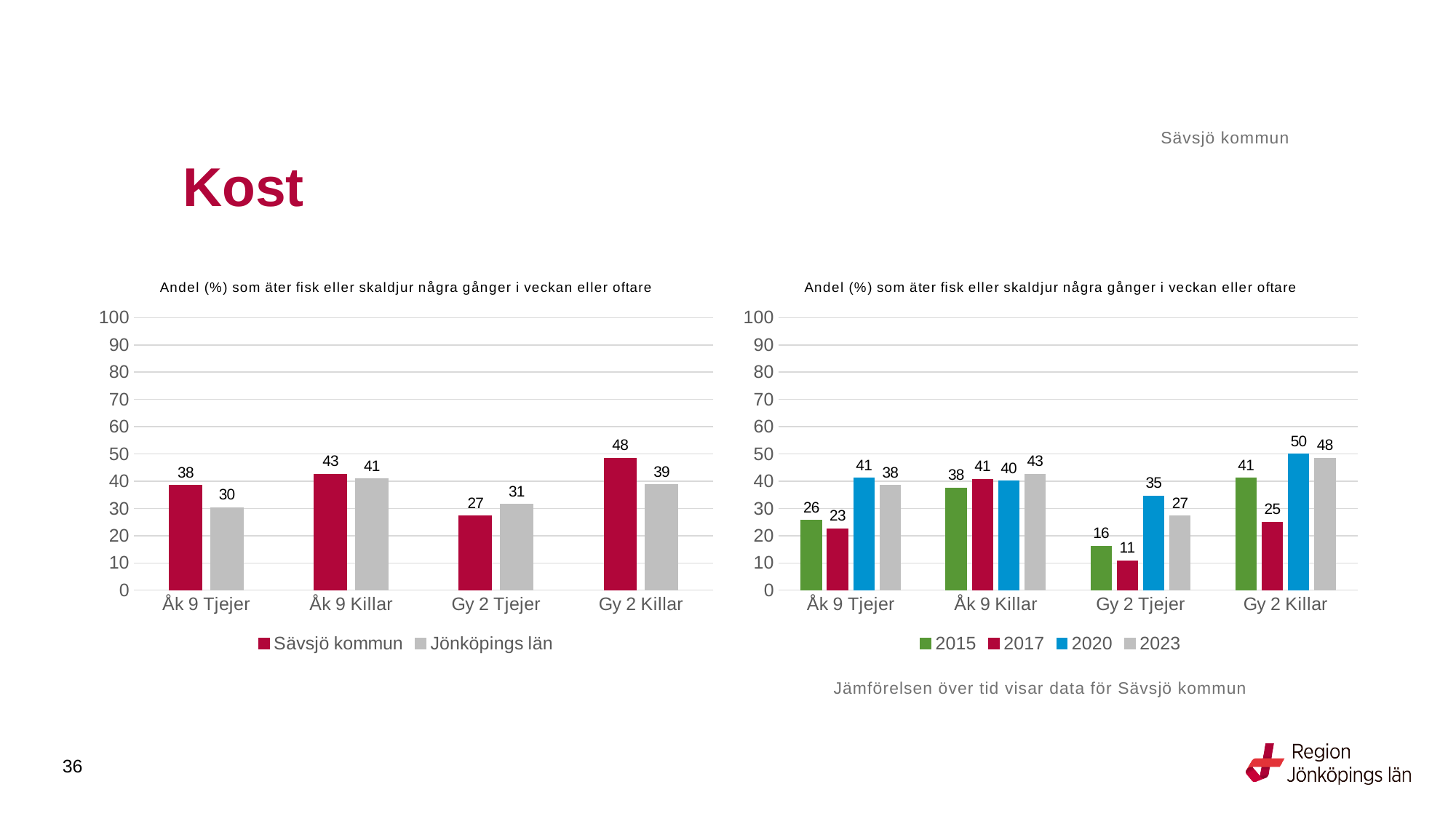
In the left chart, what is the difference between Sävsjö kommun and Jönköpings län for Gy 2 Killar? 9 In the left chart, what is the value for Jönköpings län for Åk 9 Tjejer? 30 In the right chart, what is the difference between the 2015 and 2023 values for Åk 9 Tjejer? 12 In the right chart, what is the value for 2020 for Gy 2 Killar? 50 In the left chart, how many series does the legend list? 2 In the left chart, what is the value for Sävsjö kommun for Gy 2 Killar? 48 In the left chart, which category has the lowest value for Sävsjö kommun? Gy 2 Tjejer In the right chart, how many series does the legend list? 4 In the right chart, which year has the highest value for Åk 9 Killar? 2023 In the left chart, which is larger for Gy 2 Tjejer: Sävsjö kommun or Jönköpings län? Jönköpings län In the right chart, what is the value for 2017 for Gy 2 Tjejer? 11 What type of chart is the right chart? Bar chart